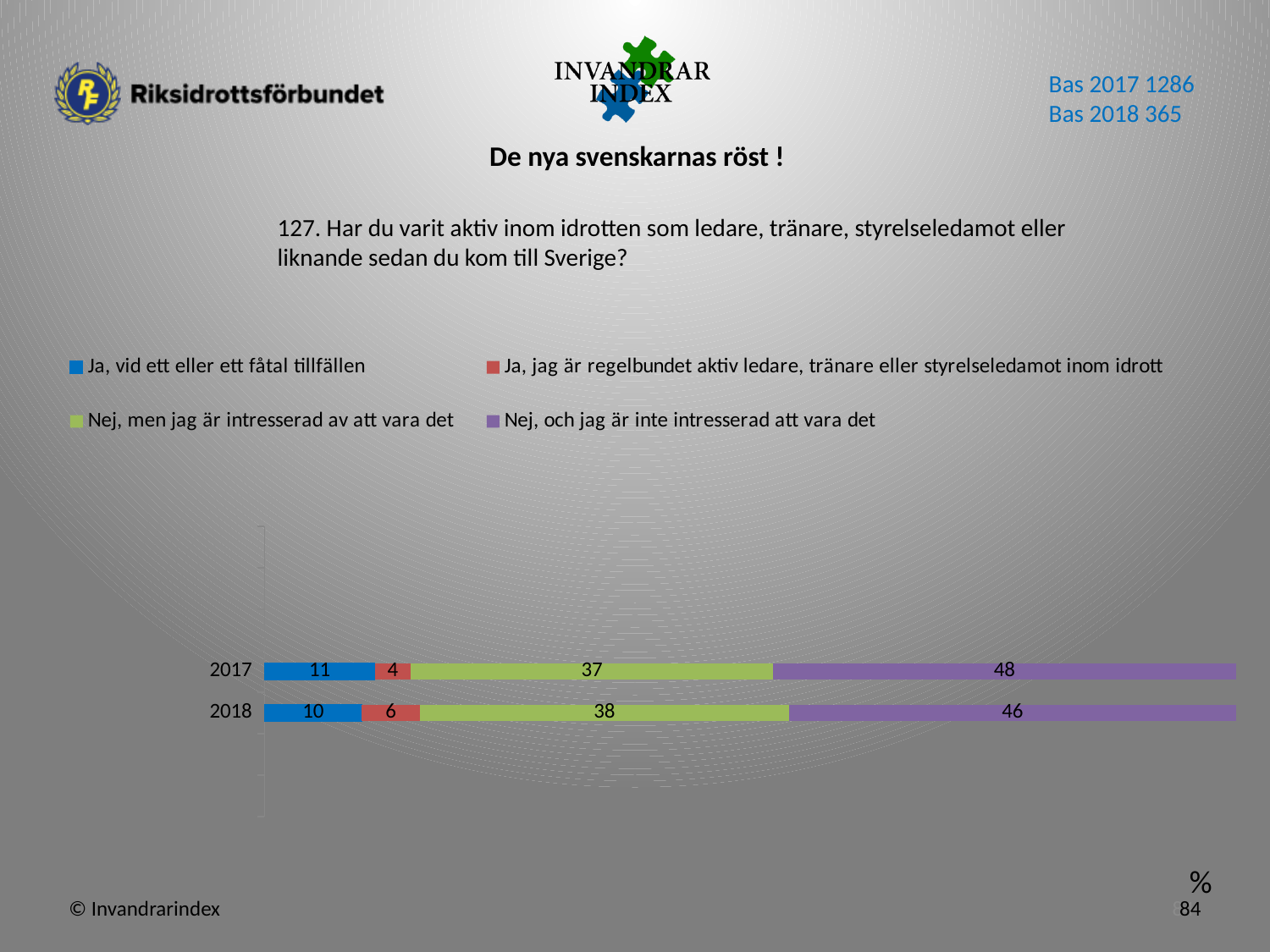
How many categories (years) are plotted on the chart? 2 What is the value for "Ja, jag är regelbundet aktiv ledare, tränare eller styrelseledamot inom idrott" in 2018? 6 What is the value for "Nej, och jag är inte intresserad att vara det" in 2018? 46 What is the value for "Ja, vid ett eller ett fåtal tillfällen" in 2017? 11 Which series has the lowest value in 2018? Ja, jag är regelbundet aktiv ledare, tränare eller styrelseledamot inom idrott What kind of chart is shown on the slide? Stacked bar chart What is the difference between the 2017 and 2018 values for "Nej, och jag är inte intresserad att vara det"? 2 How many series does the legend list? 4 Which series has the highest value in 2017? Nej, och jag är inte intresserad att vara det Is the value for "Ja, jag är regelbundet aktiv ledare, tränare eller styrelseledamot inom idrott" larger in 2017 or 2018? 2018 What is the value for "Nej, men jag är intresserad av att vara det" in 2017? 37 What is the total of the stacked bar for 2017? 100